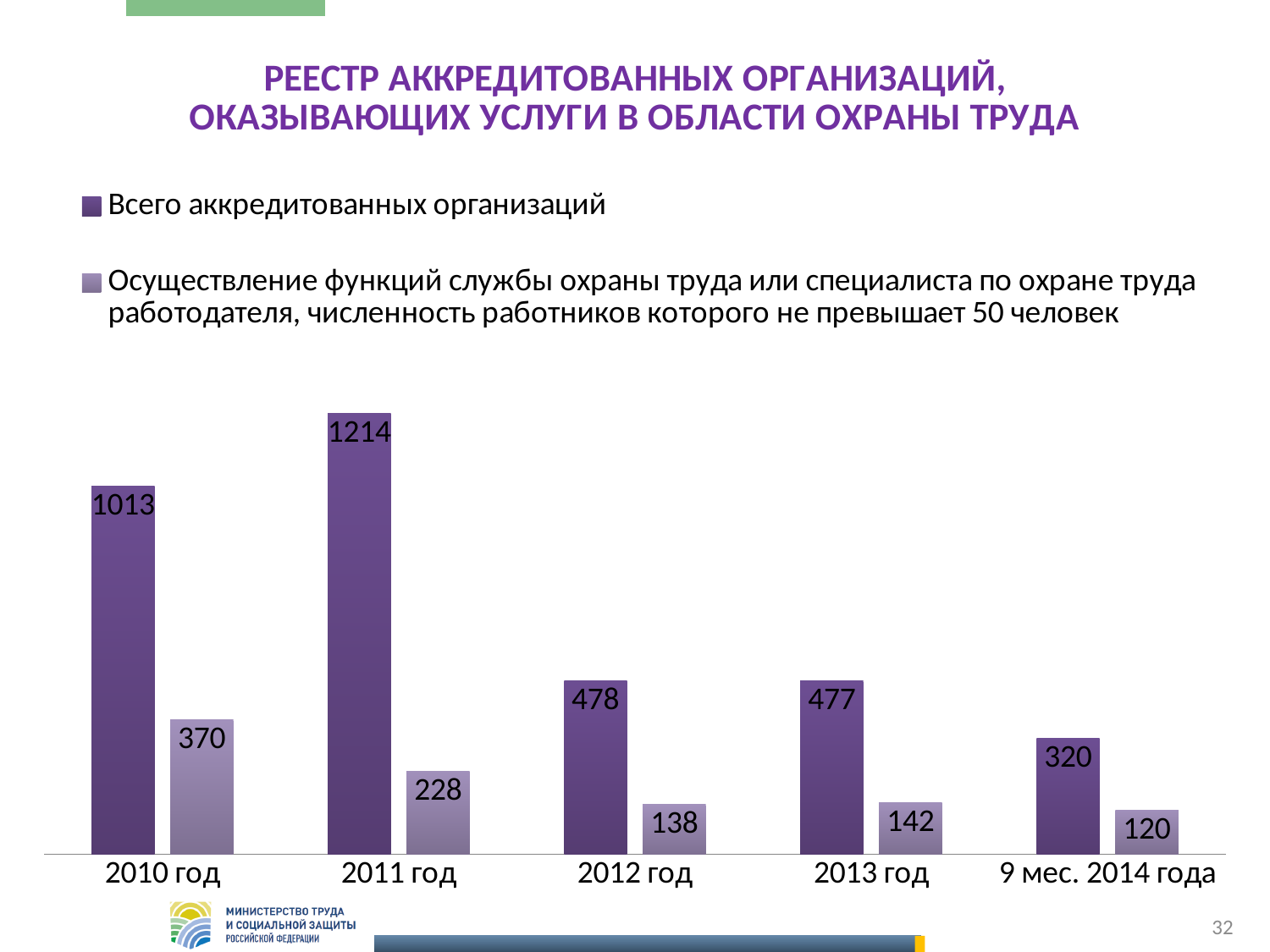
What is the value for "Осуществление функций службы охраны труда..." in 2010 год? 370 In which period is "Всего аккредитованных организаций" highest? 2011 год Which is larger: "Осуществление функций службы охраны труда..." in 2011 год or in 2012 год? 2011 год What is the difference between "Всего аккредитованных организаций" in 2011 год and 2010 год? 201 Does "Всего аккредитованных организаций" rise or fall from 2011 год to 9 мес. 2014 года? Fall What is the value for "Всего аккредитованных организаций" in 9 мес. 2014 года? 320 What kind of chart is shown on the slide? Bar chart What is the value for "Всего аккредитованных организаций" in 2011 год? 1214 In which period is "Осуществление функций службы охраны труда..." lowest? 9 мес. 2014 года How many series does the legend list? 2 What is the difference between "Всего аккредитованных организаций" and "Осуществление функций службы охраны труда..." in 2013 год? 335 How many periods are shown on the x axis? 5